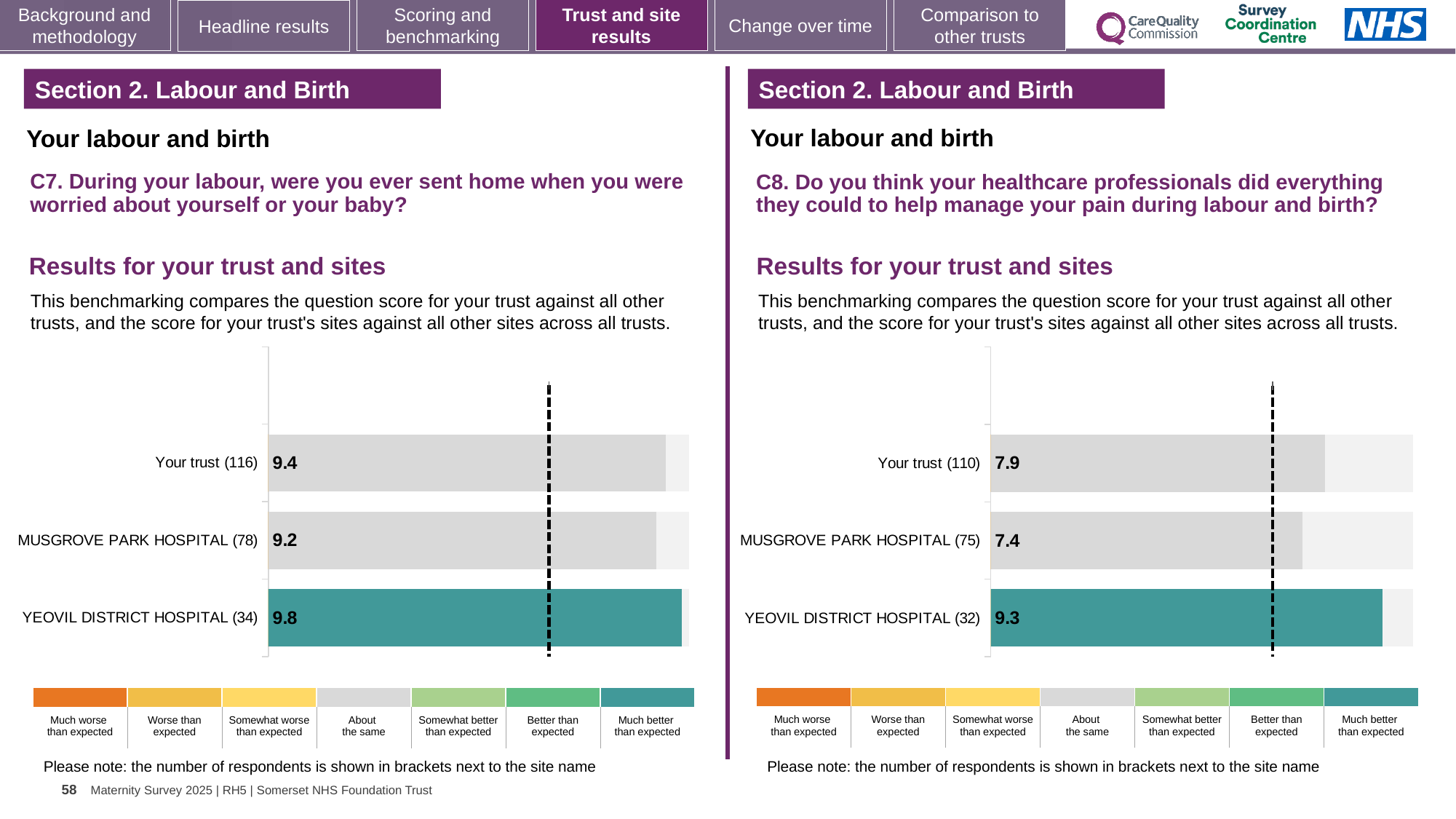
In the left chart (C7), which site or trust has the highest score? YEOVIL DISTRICT HOSPITAL In the right chart (C8), how many respondents are shown in brackets for MUSGROVE PARK HOSPITAL? 75 In the right chart (C8), which site or trust has the lowest score? MUSGROVE PARK HOSPITAL In the right chart (C8), what is the difference between the scores for YEOVIL DISTRICT HOSPITAL and Your trust? 1.4 In the right chart (C8), what is the score for YEOVIL DISTRICT HOSPITAL? 9.3 What kind of chart is used on the left (C7)? Bar chart In the left chart (C7), what is the score for MUSGROVE PARK HOSPITAL? 9.2 In the left chart (C7), what is the difference between the scores for YEOVIL DISTRICT HOSPITAL and MUSGROVE PARK HOSPITAL? 0.6 In the right chart (C8), which has the larger score, Your trust or MUSGROVE PARK HOSPITAL? Your trust In the left chart (C7), what is the score for Your trust? 9.4 In the left chart (C7), how many bars are plotted? 3 In the right chart (C8), what is the score for Your trust? 7.9